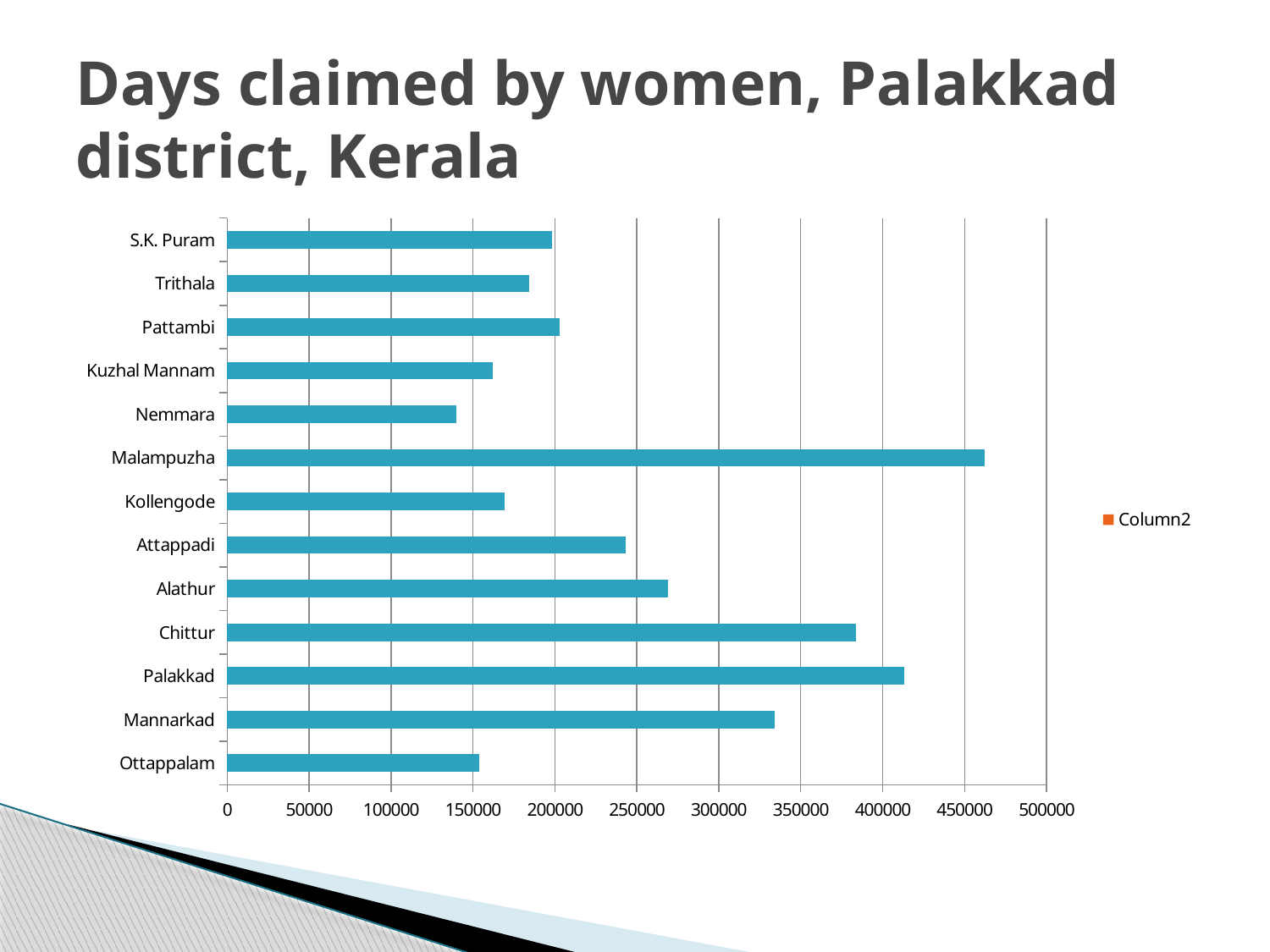
Which category has the highest value? Malampuzha What kind of chart is shown on the slide? bar chart What is the name of the series shown in the legend? Column2 Is the value for Palakkad greater or less than 400000? greater How many categories (blocks) are plotted on the chart? 13 Is the value for Mannarkad greater or less than 350000? less Which category has the lowest value? Nemmara How many series does the legend list? 1 Which is larger, the value for Palakkad or the value for Chittur? Palakkad Which is larger, the value for Alathur or the value for Attappadi? Alathur Is the value for Nemmara greater or less than 150000? less